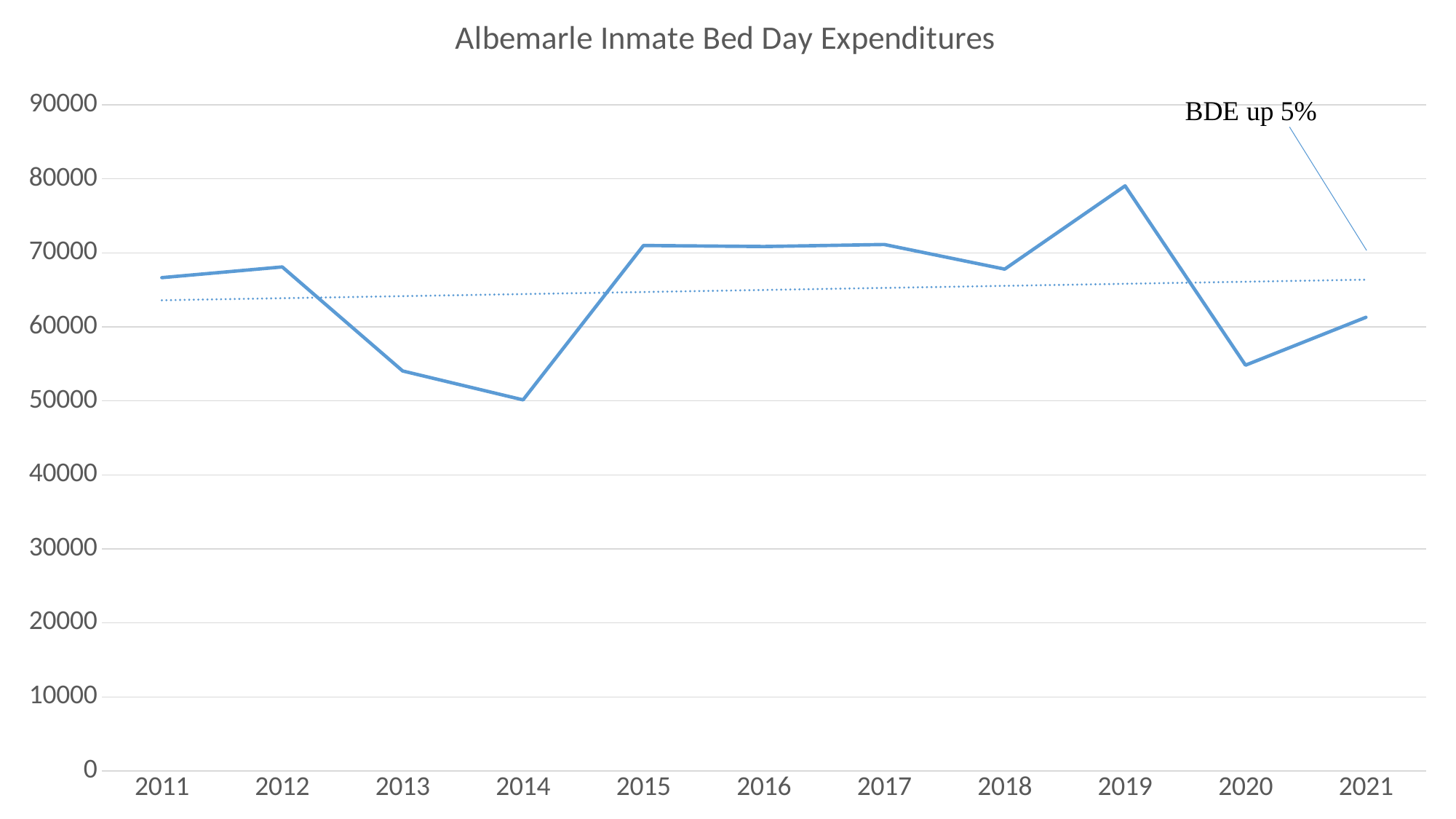
Is the value for 2013 greater or less than 50000? greater Which year has the highest expenditure? 2019 Is the value for 2020 greater or less than 60000? less How many years are plotted along the x axis? 11 Is the value for 2012 greater or less than 70000? less Do expenditures rise or fall from 2019 to 2020? fall Which year has the lowest expenditure? 2014 What does the text annotation near the 2021 point say? BDE up 5% Which year has the larger expenditure, 2019 or 2020? 2019 What is the title of the chart? Albemarle Inmate Bed Day Expenditures What kind of chart is shown on the slide? line chart